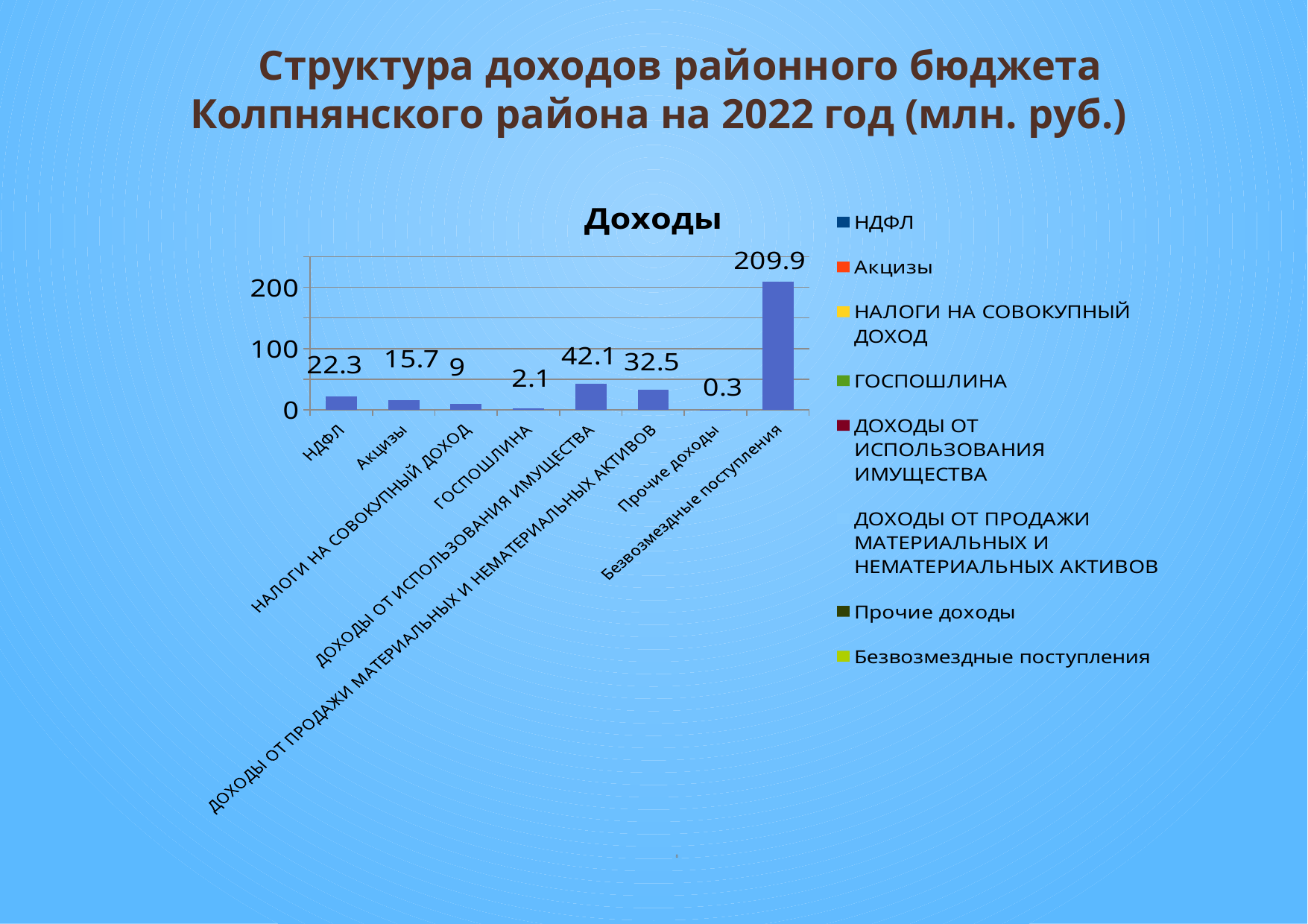
What kind of chart is shown on the slide? bar chart What is the value for ДОХОДЫ ОТ ИСПОЛЬЗОВАНИЯ ИМУЩЕСТВА? 42.1 What is the value for НДФЛ? 22.3 Is the value for Безвозмездные поступления greater or less than 200? greater Which category has the lowest value? Прочие доходы What is the value for Прочие доходы? 0.3 Which category has the highest value? Безвозмездные поступления How many categories are shown on the x axis? 8 What is the difference between the values for ДОХОДЫ ОТ ИСПОЛЬЗОВАНИЯ ИМУЩЕСТВА and ДОХОДЫ ОТ ПРОДАЖИ МАТЕРИАЛЬНЫХ И НЕМАТЕРИАЛЬНЫХ АКТИВОВ? 9.6 What is the title of the chart? Доходы What is the value for Безвозмездные поступления? 209.9 Which is larger, the value for НДФЛ or the value for Акцизы? НДФЛ